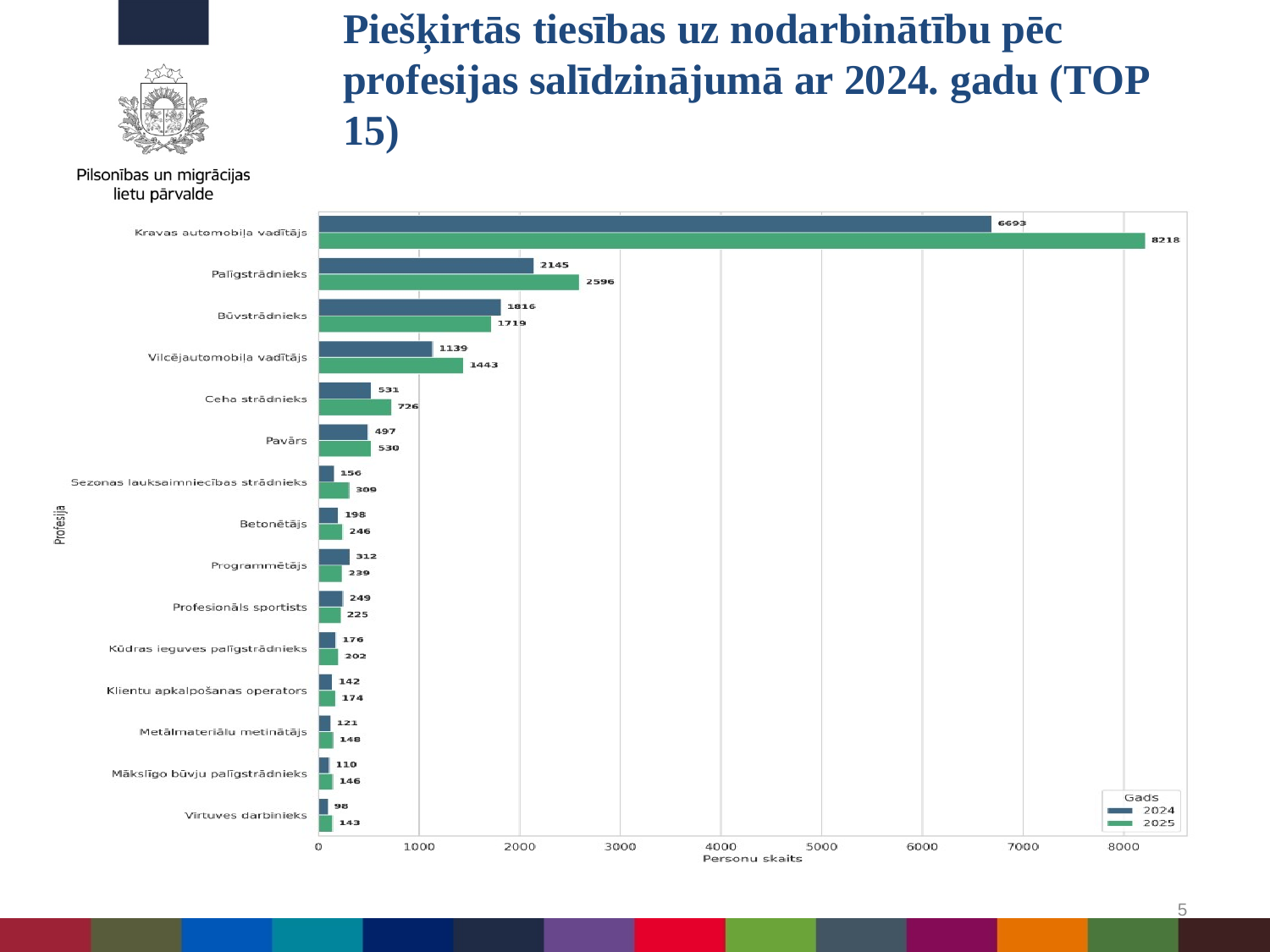
What is the 2025 value for Kravas automobiļa vadītājs? 8218 Is the 2024 value for Būvstrādnieks greater or less than 2000? less How many professions are shown on the chart? 15 For Programmētājs, which year has the larger value, 2024 or 2025? 2024 What is the difference between the 2025 and 2024 values for Palīgstrādnieks? 451 What is the title of the legend on the chart? Gads Which profession has the highest 2025 value? Kravas automobiļa vadītājs What kind of chart is shown on the slide? bar chart Which profession has the lowest 2024 value? Virtuves darbinieks What is the 2024 value for Palīgstrādnieks? 2145 How many series does the legend list? 2 What is the 2025 value for Ceha strādnieks? 726